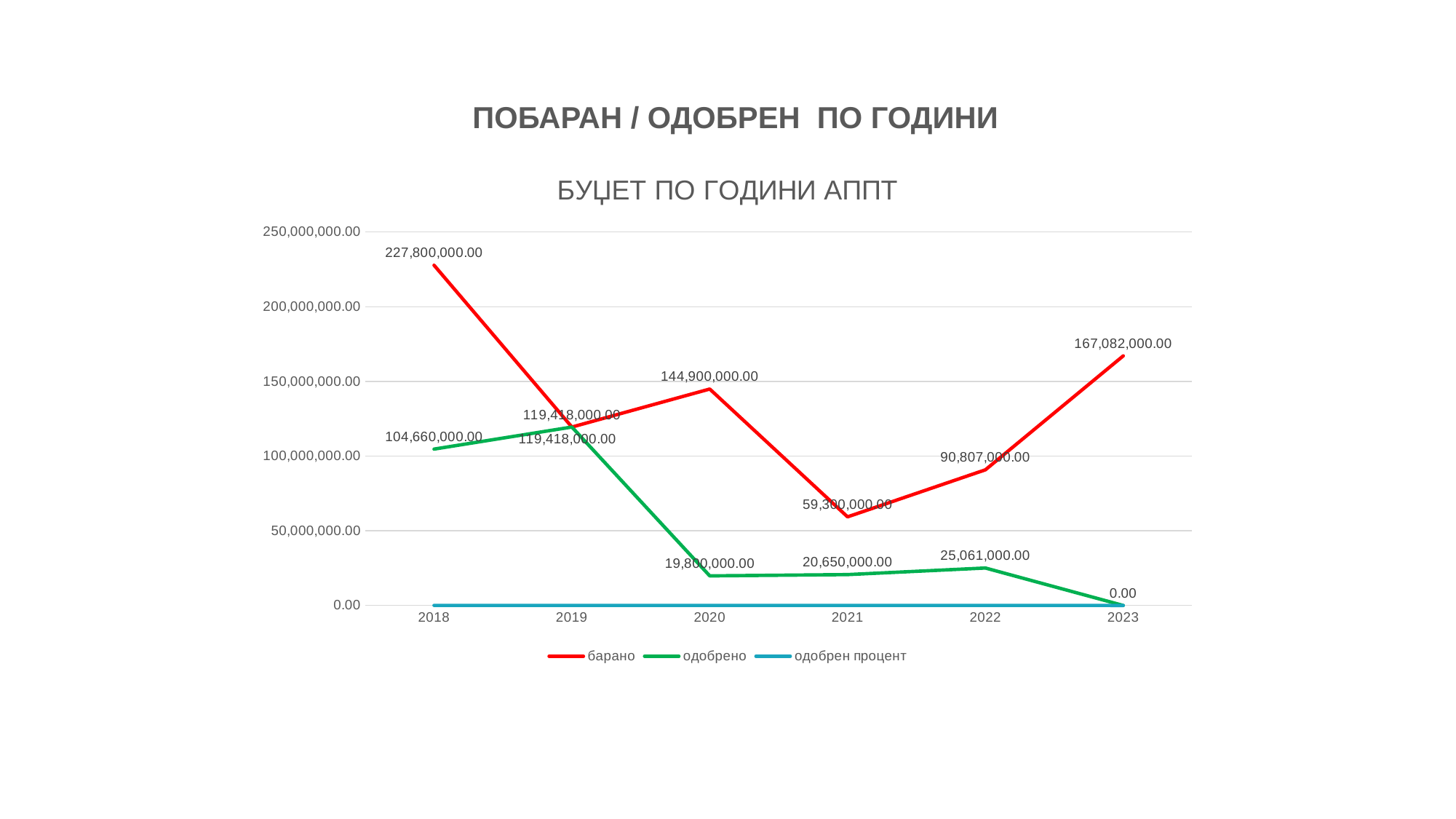
How many series does the legend list? 3 In which year is барано the lowest? 2021 In which year is барано the highest? 2018 Does одобрено rise or fall from 2019 to 2020? fall Which is larger in 2022, барано or одобрено? барано What is the value of барано in 2021? 59,300,000.00 What type of chart is shown on the slide? line chart What is the value of одобрено in 2022? 25,061,000.00 What is the difference between барано and одобрено in 2020? 125,100,000.00 What is the value of одобрено in 2023? 0.00 How many years are shown on the x axis? 6 What is the value of барано in 2018? 227,800,000.00